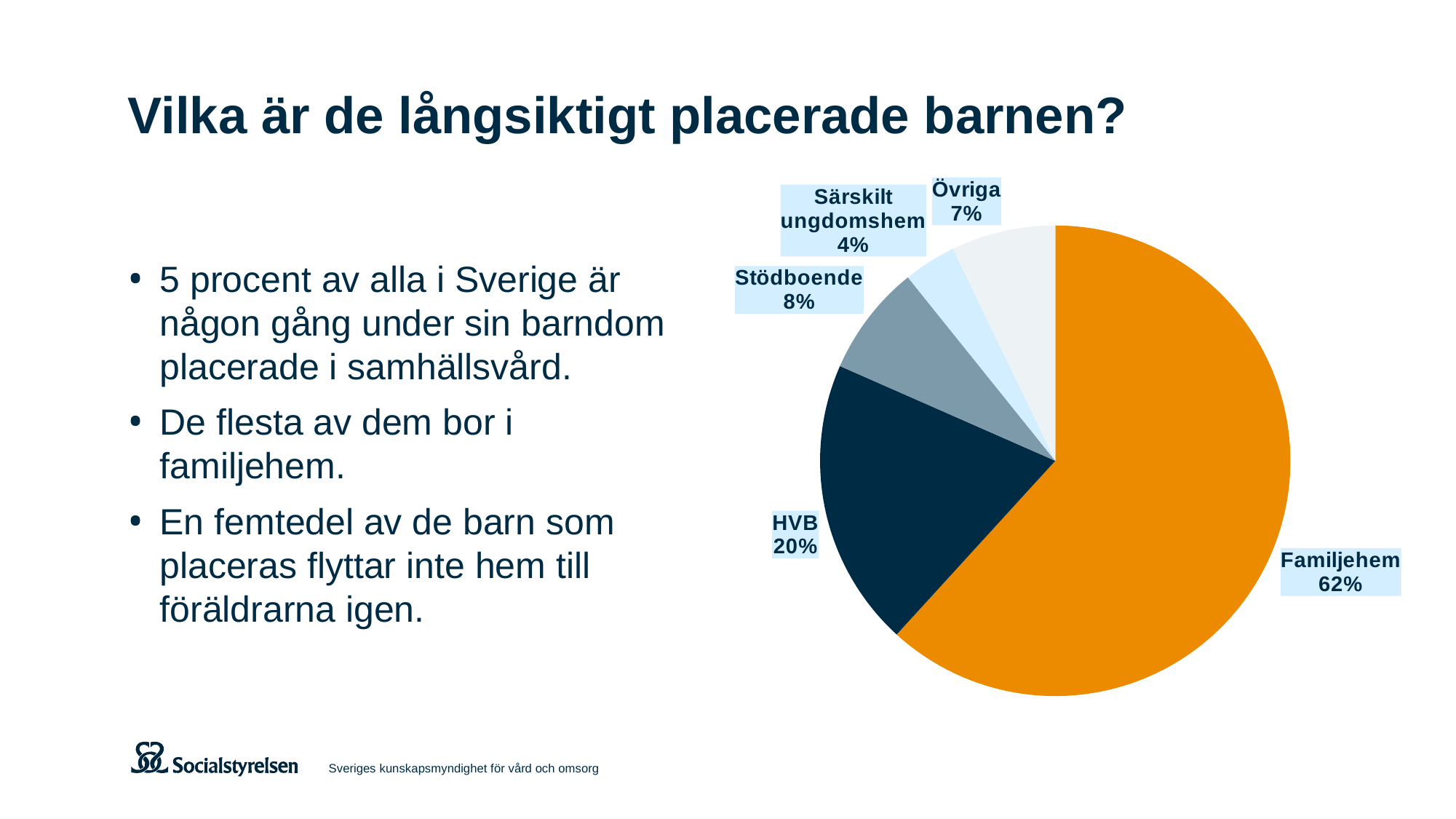
What colour is the Familjehem slice? Orange What share of the pie does Familjehem have? 62% What is the value for HVB? 20% What is the value for Övriga? 7% Which is larger, Stödboende or Övriga? Stödboende What kind of chart is shown on the slide? Pie chart What is the difference between Familjehem and HVB? 42 percentage points Which category has the largest slice? Familjehem What is the value for Särskilt ungdomshem? 4% What is the value for Stödboende? 8% Which category has the smallest slice? Särskilt ungdomshem How many categories are shown in the pie chart? 5